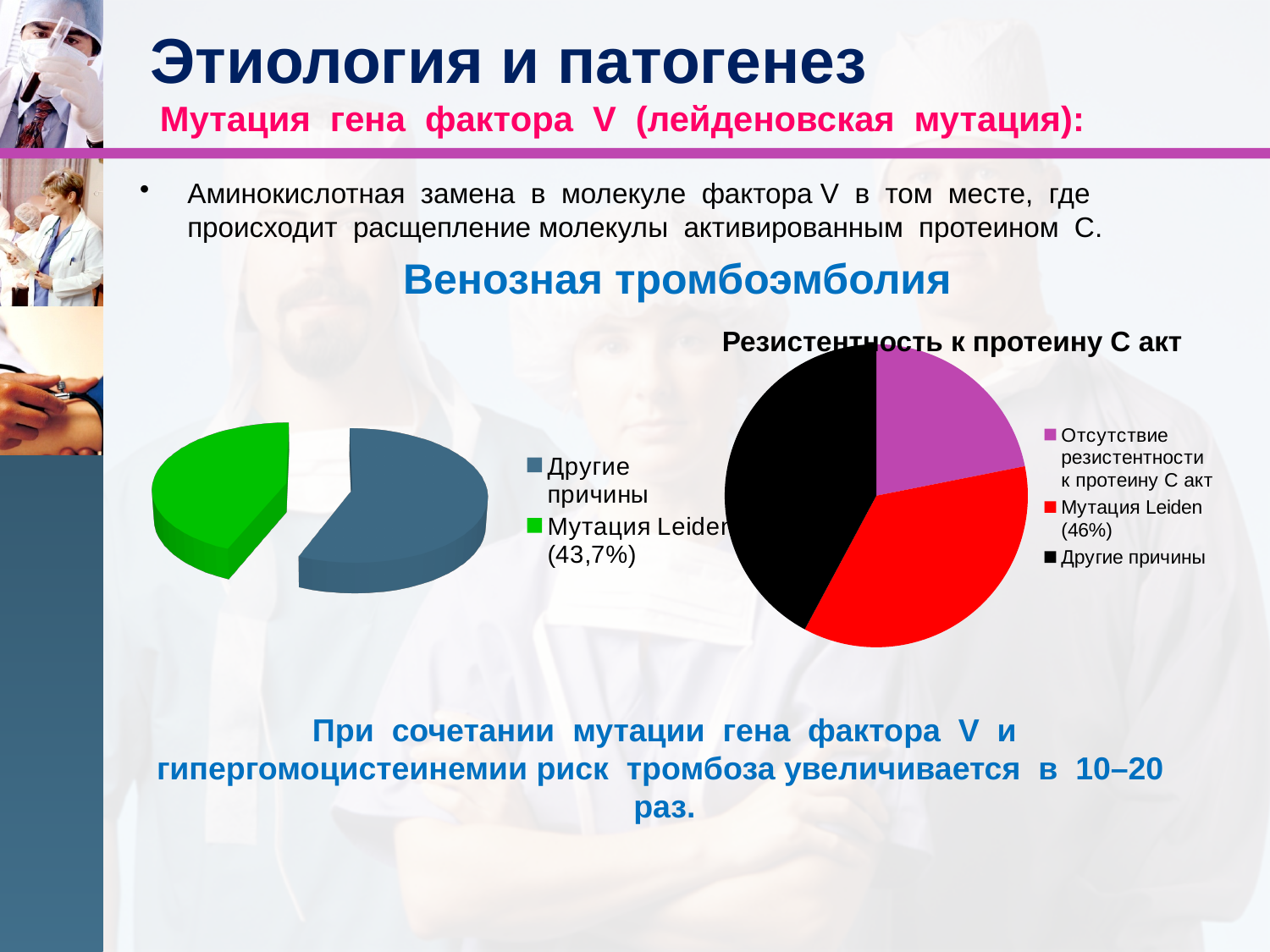
In the left chart, which category has the largest slice? Другие причины In the left chart, what share is given for 'Мутация Leiden'? 43,7% In the left chart, how many entries does the legend list? 2 In the left chart, which slice is larger: 'Другие причины' or 'Мутация Leiden'? Другие причины What kind of chart is the right chart titled 'Резистентность к протеину С акт'? pie chart What kind of chart is the left chart (with the legend 'Другие причины' and 'Мутация Leiden (43,7%)')? pie chart In the right chart titled 'Резистентность к протеину С акт', which category has the smallest slice? Отсутствие резистентности к протеину С акт In the right chart titled 'Резистентность к протеину С акт', what share is given for 'Мутация Leiden'? 46% What is the title of the right chart? Резистентность к протеину С акт In the right chart titled 'Резистентность к протеину С акт', what colour is the 'Мутация Leiden (46%)' slice? red In the right chart titled 'Резистентность к протеину С акт', how many slices does the pie have? 3